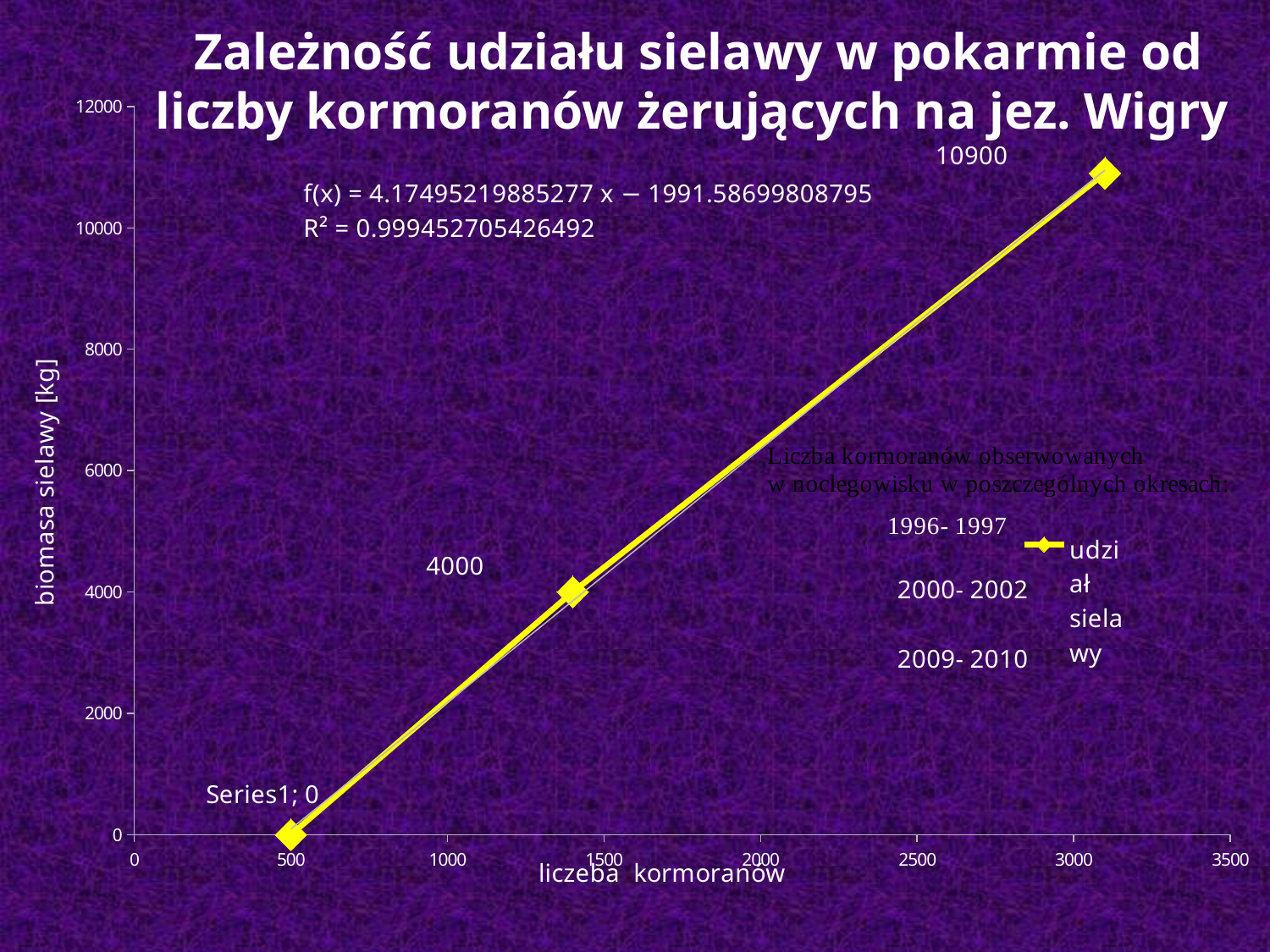
Which is larger, the biomass value of the middle point or of the rightmost point? the rightmost point (10900) What kind of chart is shown on the slide? line chart What is the difference between the highest labelled value (10900) and the middle labelled value (4000)? 6900 How many series does the legend list? 1 Is the middle data point's biomass value greater or less than 6000? less What is the lowest biomass value labelled on the chart? 0 What is the highest biomass value labelled on the chart? 10900 What is the name of the series shown in the legend? udział sielawy What is the biomass value labelled at the point where the number of cormorants is 500? 0 Do the biomass values rise or fall as the number of cormorants increases along the x axis? rise How many data points are plotted on the chart? 3 What R² value is printed for the trendline on the chart? 0.999452705426492